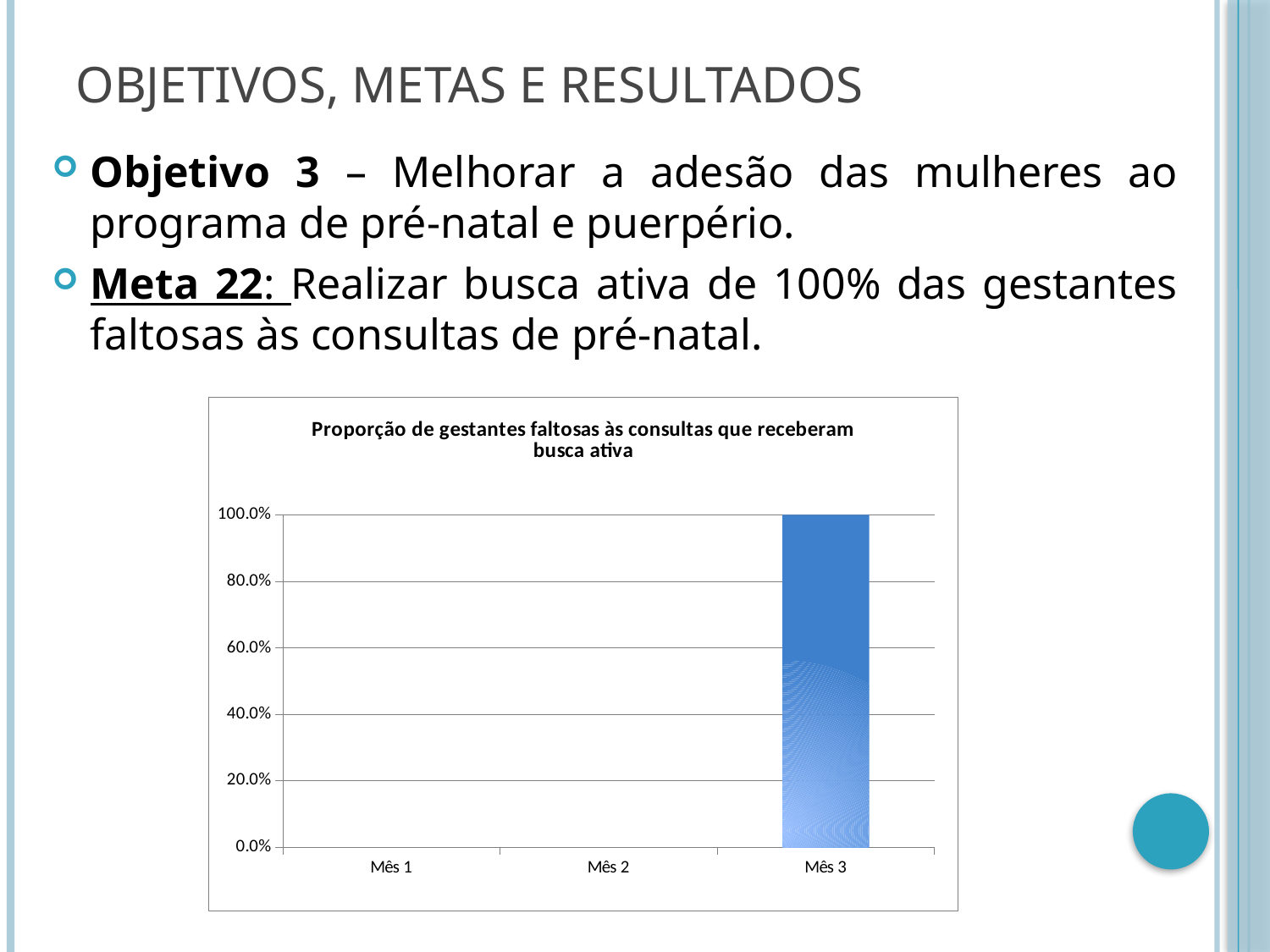
Is the value for Mês 1 greater or less than 20.0%? less What is the value for Mês 3 in the chart? 100.0% Which is larger, the value for Mês 2 or the value for Mês 3? Mês 3 Do the values rise or fall from Mês 2 to Mês 3? rise What is the title of the chart? Proporção de gestantes faltosas às consultas que receberam busca ativa What is the highest value shown on the y axis of the chart? 100.0% What type of chart is shown on the slide? bar chart Which category has the highest value in the chart? Mês 3 How many categories are shown on the x axis of the chart? 3 Is the value for Mês 3 greater or less than 80.0%? greater Is the value for Mês 2 greater or less than 20.0%? less